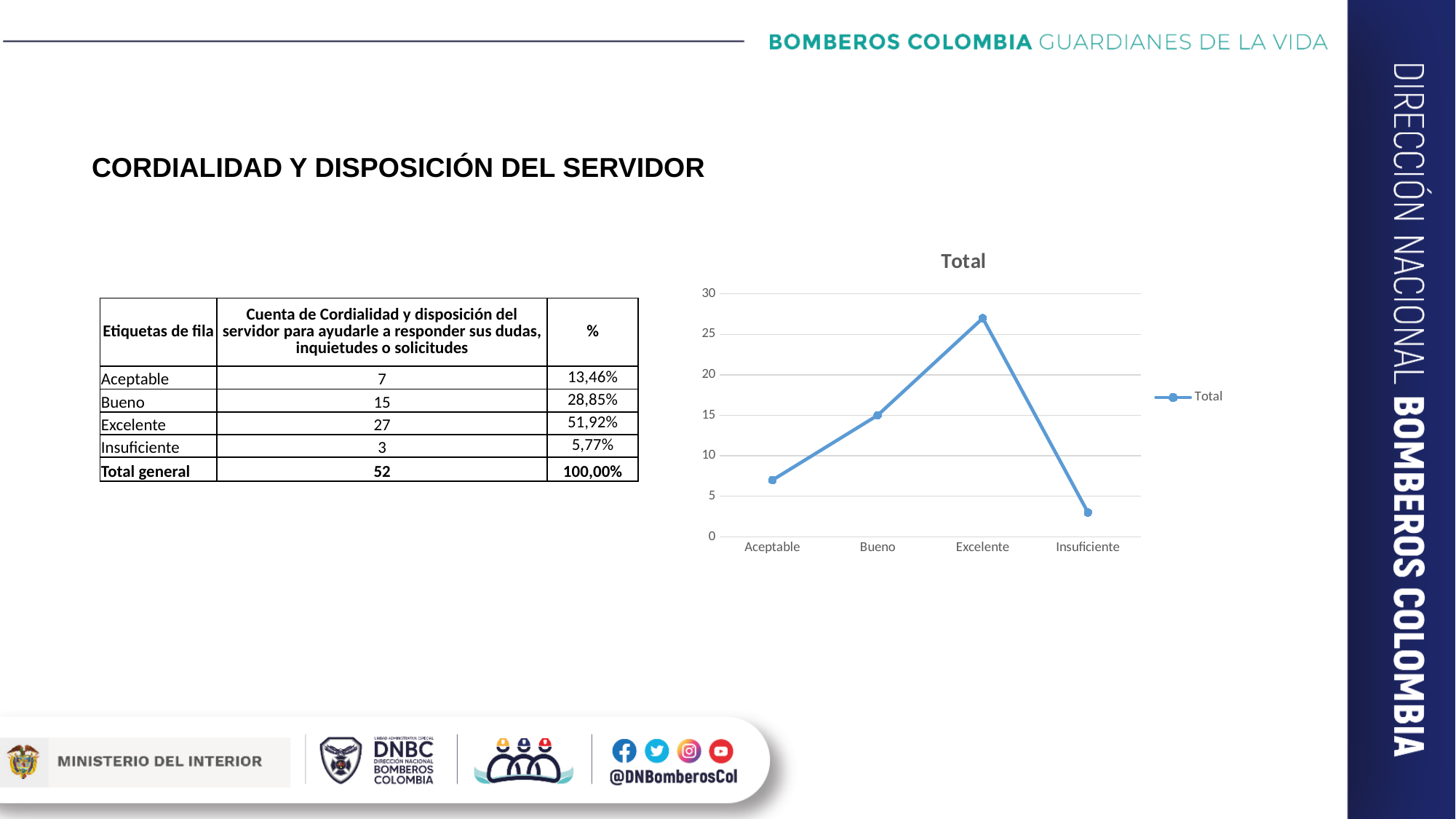
Is the value for Aceptable greater or less than 10? less Is the value for Excelente greater or less than 25? greater Which category has the highest value in the chart? Excelente Which category has the lowest value in the chart? Insuficiente What is the value for Bueno in the chart? 15 What is the value for Excelente in the chart? 27 How many categories are plotted along the x axis of the chart? 4 How many series does the chart legend list? 1 What is the difference between the values for Excelente and Aceptable? 20 What kind of chart is shown on the slide? line chart What is the title of the chart? Total Which is larger, the value for Bueno or the value for Insuficiente? Bueno